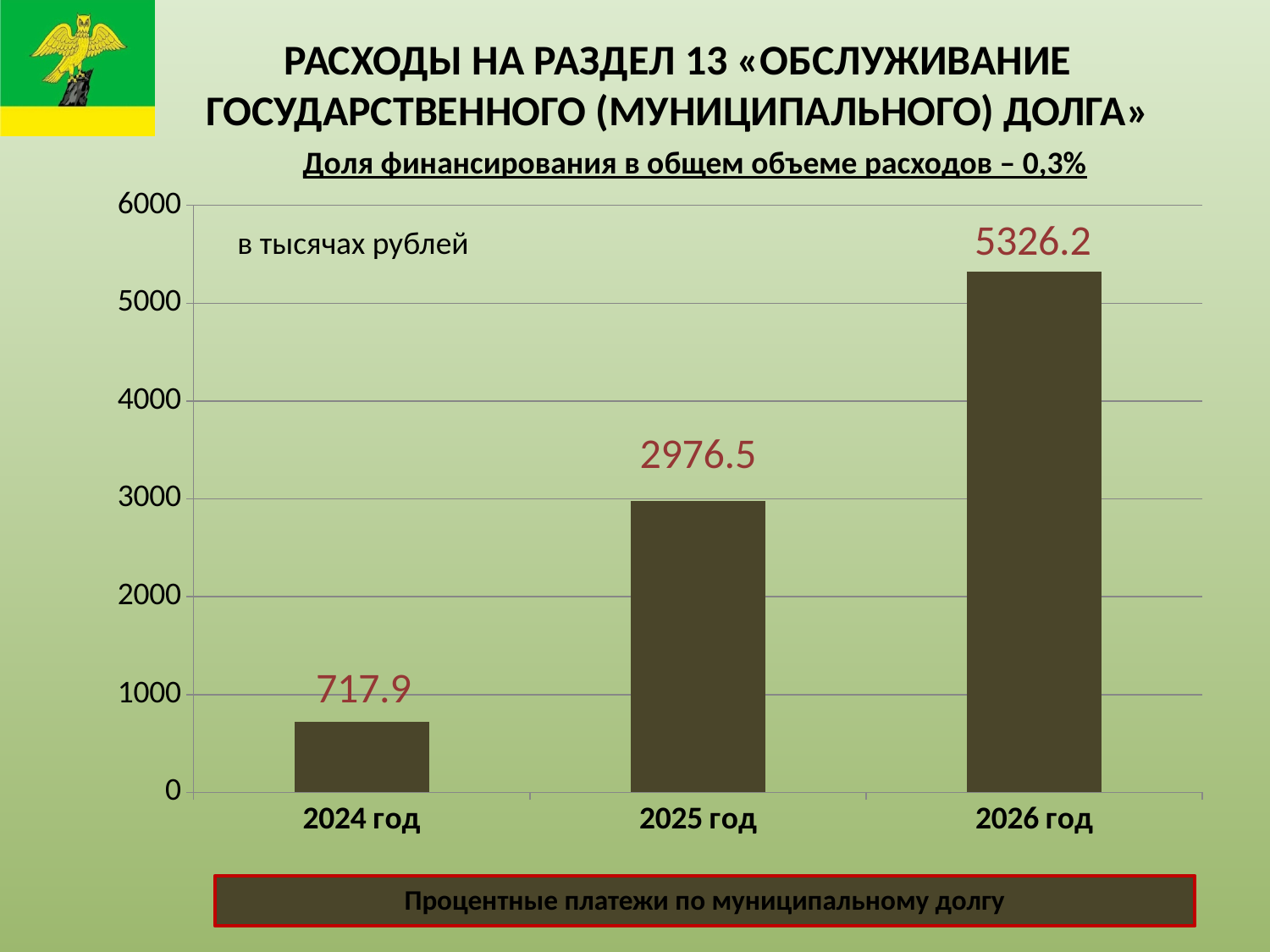
Which year has the highest value? 2026 год Which year has the lowest value? 2024 год How many years are shown on the chart? 3 What kind of chart is shown on the slide? bar chart Do the values rise or fall from 2024 год to 2026 год? rise What is the value for 2024 год? 717.9 Is the value for 2026 год greater or less than 5000? greater What is the difference between the values for 2026 год and 2025 год? 2349.7 What is the difference between the values for 2025 год and 2024 год? 2258.6 Which is larger, the value for 2024 год or the value for 2025 год? 2025 год What is the value for 2025 год? 2976.5 What is the value for 2026 год? 5326.2